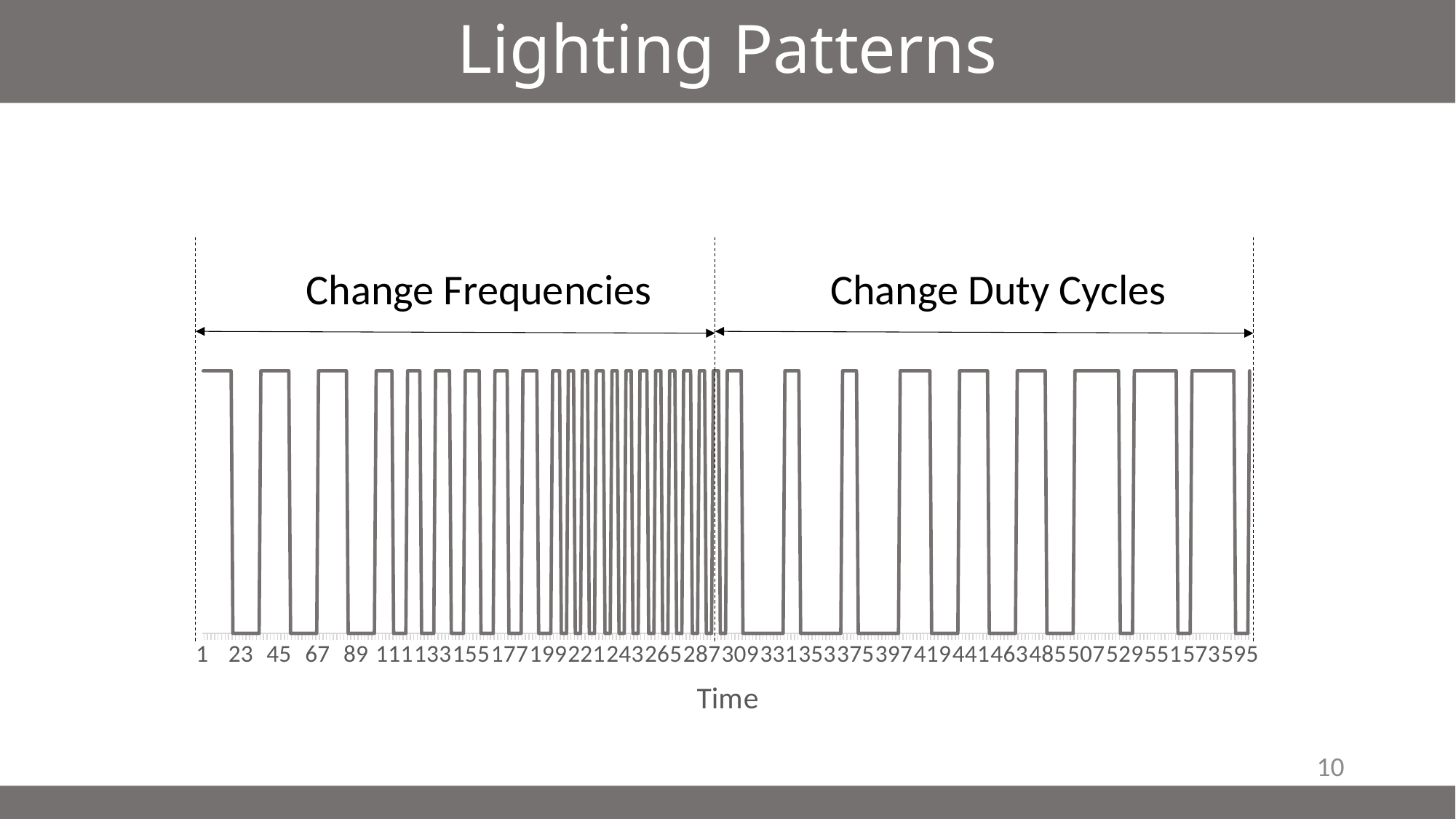
What label is written above the left section of the chart? Change Frequencies What kind of chart is shown on the slide? line chart How many labelled sections is the chart divided into by the dotted vertical lines? 2 What is the first tick label on the x axis of the chart? 1 In the 'Change Frequencies' section, do the pulses become more frequent or less frequent moving from left to right along the x axis? more frequent What is the title of the x axis of the chart? Time What is the last tick label on the x axis of the chart? 595 Which section of the chart contains the narrower, more closely spaced pulses: 'Change Frequencies' or 'Change Duty Cycles'? Change Frequencies